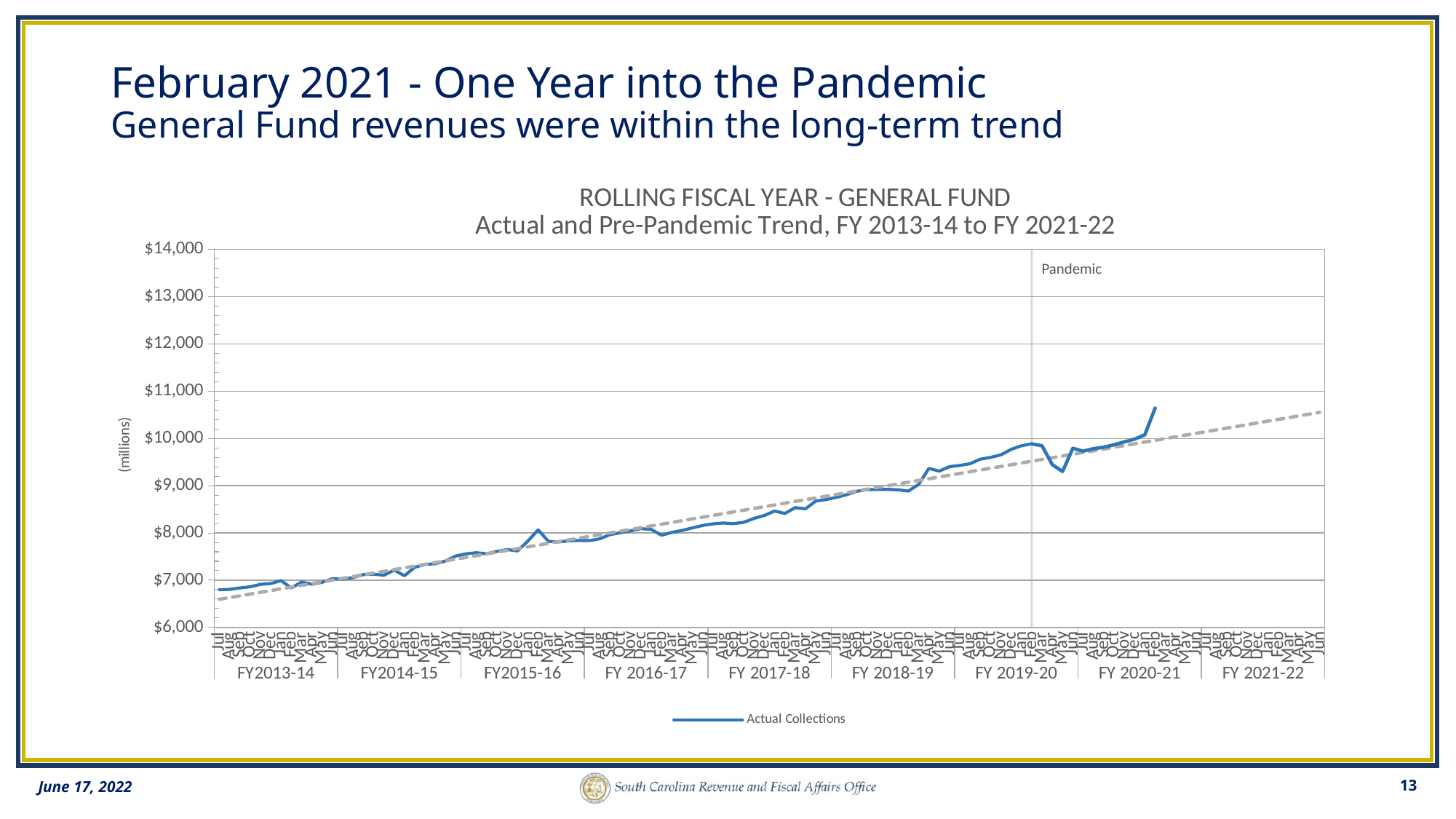
In which fiscal year does the Actual Collections line reach its highest point? FY 2020-21 Do the Actual Collections values generally rise or fall from FY2013-14 to FY2020-21? Rise What is the name of the series shown in the legend? Actual Collections What is the title of the chart? ROLLING FISCAL YEAR - GENERAL FUND Actual and Pre-Pandemic Trend, FY 2013-14 to FY 2021-22 How many series does the chart legend list? 1 How many fiscal years are labeled along the x axis? 9 What kind of chart is shown on the slide? Line chart Is the Actual Collections value for Jan of FY2019-20 greater or less than $9,000? greater Is the Actual Collections value for May of FY2019-20 greater or less than $10,000? less Is the Actual Collections value for Jul of FY2013-14 greater or less than $7,000? less